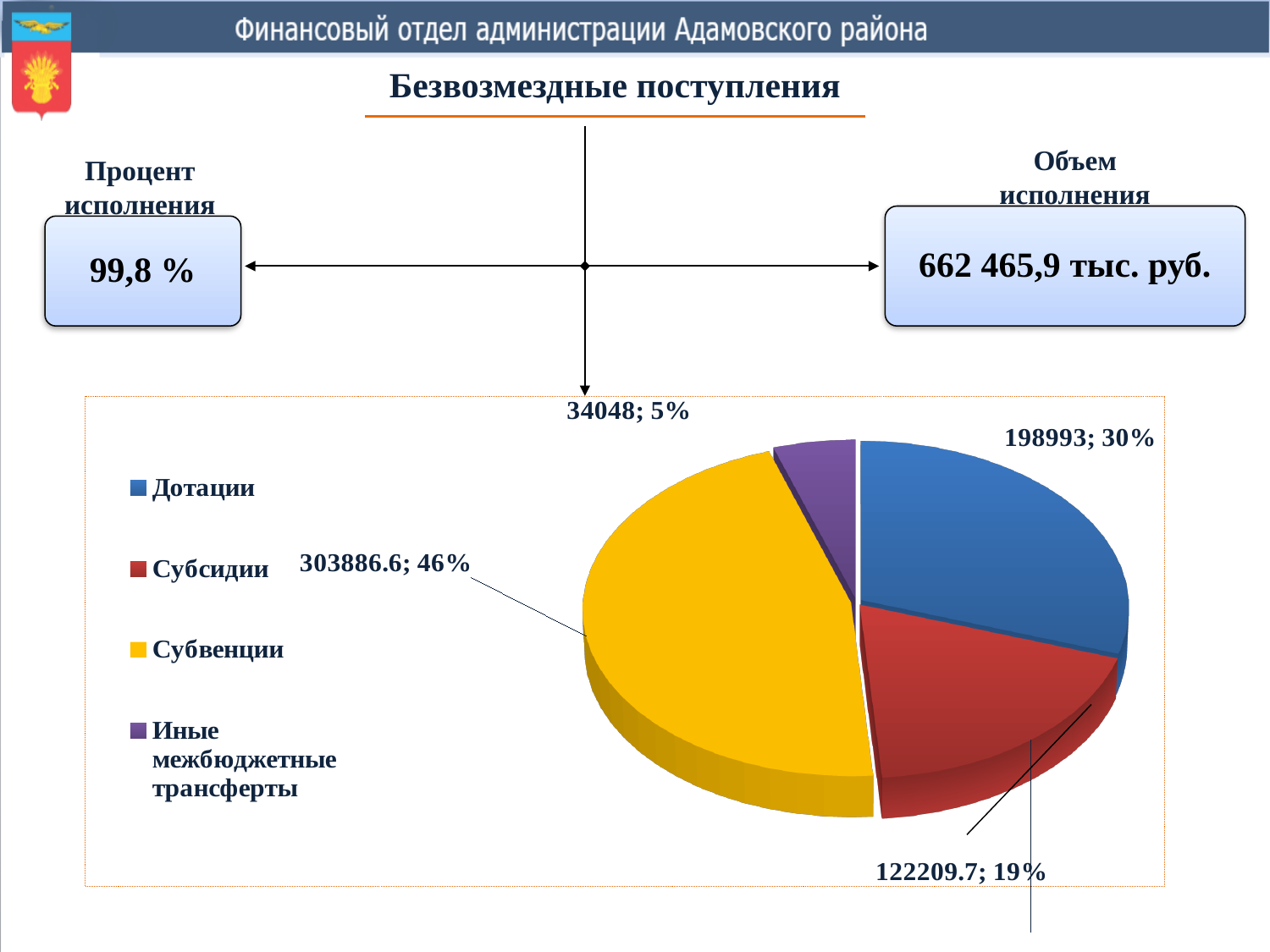
How many entries does the legend of the pie chart list? 4 What kind of chart is shown on the slide? pie chart What is the value shown for Дотации in the pie chart? 198993 What is the value shown for Иные межбюджетные трансферты in the pie chart? 34048 What is the value shown for Субвенции in the pie chart? 303886.6 Which colour represents Субсидии in the pie chart? red How many slices does the pie chart have? 4 What is the difference between the values for Субвенции and Дотации? 104893.6 Which category has the smallest slice in the pie chart? Иные межбюджетные трансферты What share of the pie does Субвенции represent? 46% Which category has the largest slice in the pie chart? Субвенции What share of the pie does Субсидии represent? 19%